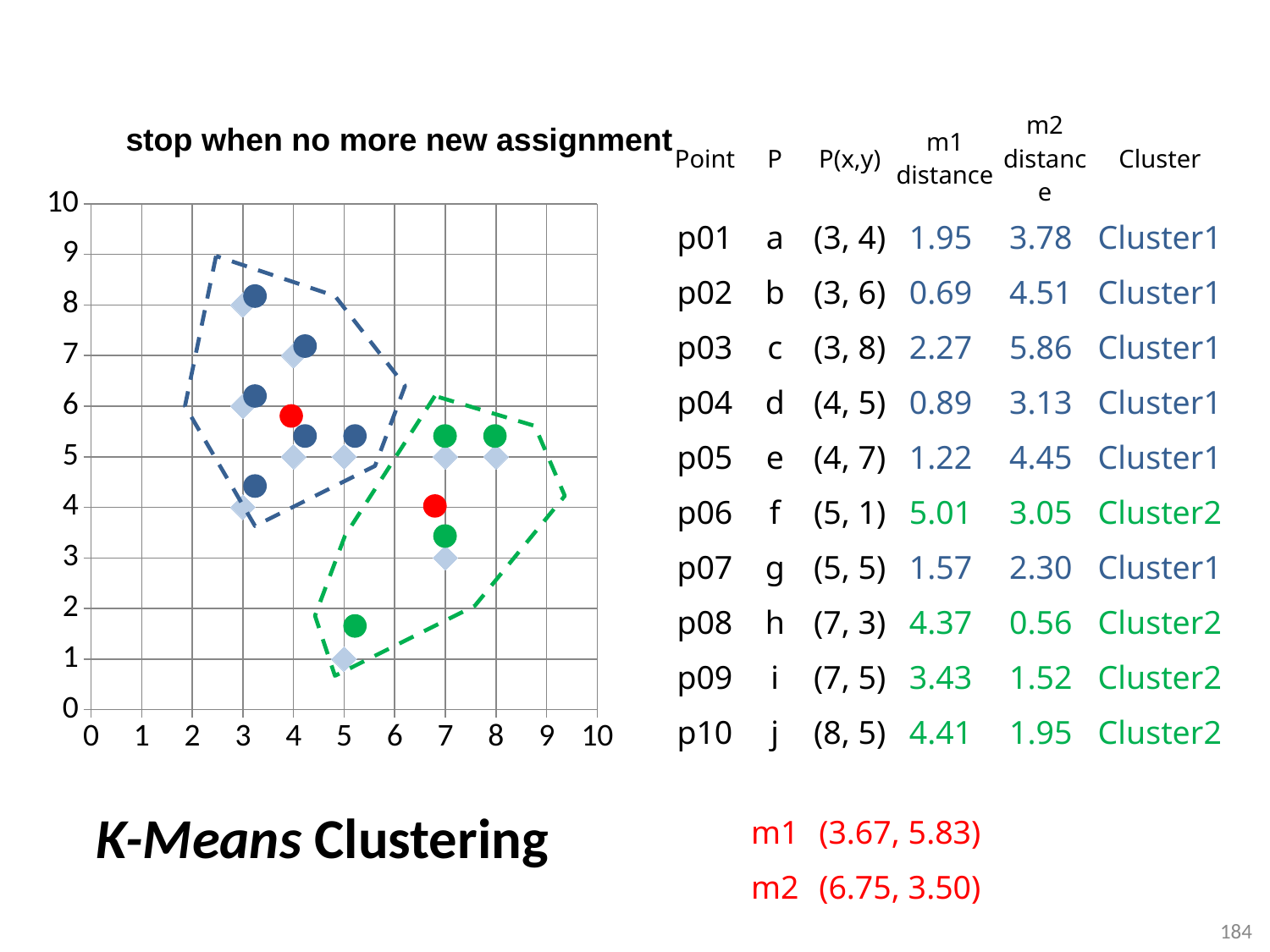
How many red circles (centroids) are plotted on the chart? 2 What kind of chart is shown on the slide? scatter chart What are the coordinates of point h? (7, 3) Which point has the lowest y value on the chart? f (5, 1) Which point has the largest x value on the chart? j (8, 5) How many light-blue diamond data points are plotted on the chart? 10 What is the maximum value shown on the chart's y axis? 10 What are the coordinates of the centroid m1? (3.67, 5.83) What is the difference in y value between point c (3, 8) and point f (5, 1)? 7 Which point has the larger x value, point h or point a? h What is the title printed above the chart? stop when no more new assignment Which point has the highest y value on the chart? c (3, 8)